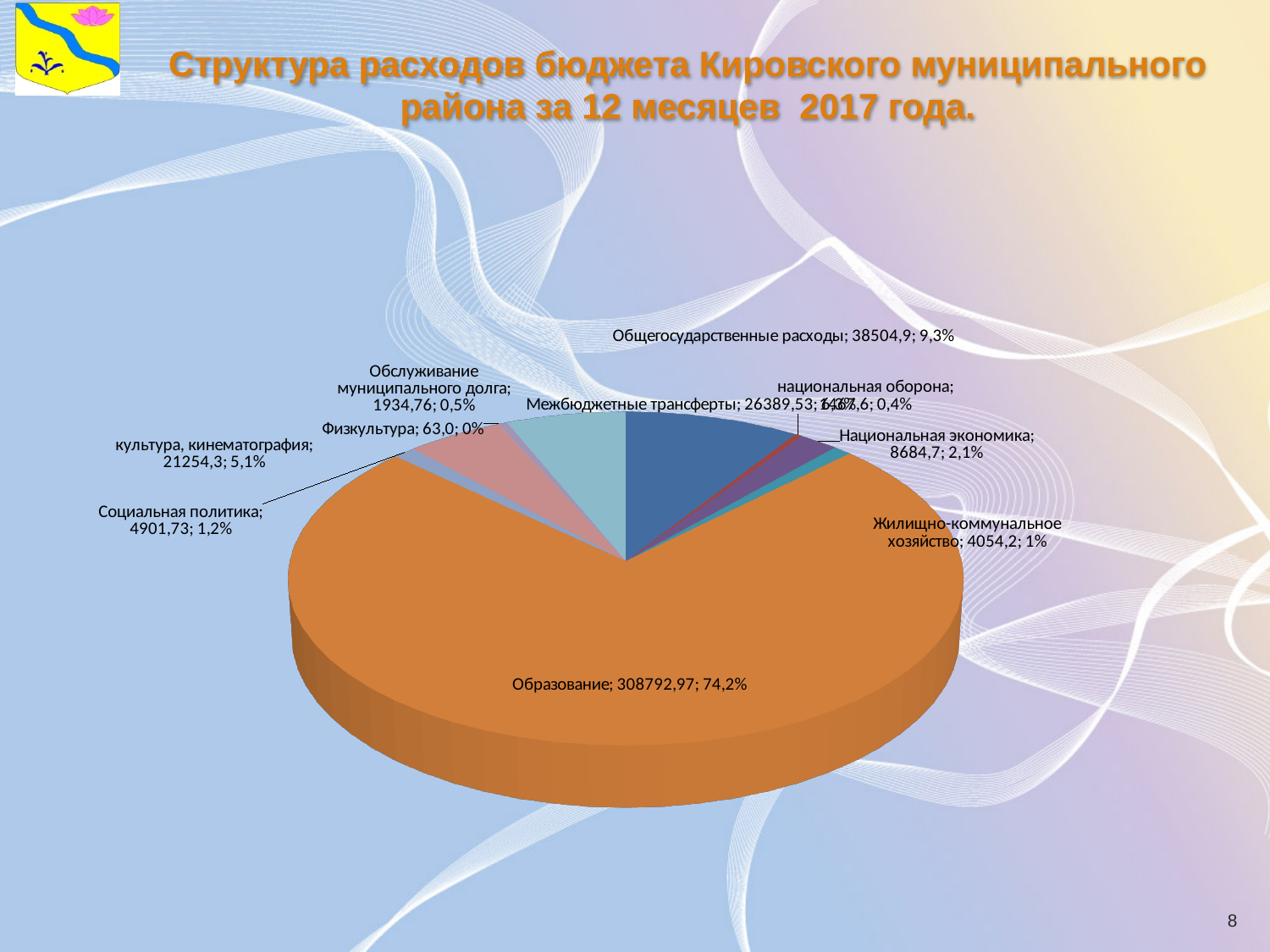
What is the value shown for Общегосударственные расходы? 38504,9 What is the value shown for Образование? 308792,97 Which is larger: the value for Национальная экономика or the value for Жилищно-коммунальное хозяйство? Национальная экономика What is the value shown for Социальная политика? 4901,73 Which category has the smallest share of the budget expenditures? Физкультура What is the difference in percentage share between Общегосударственные расходы and культура, кинематография? 4,2% What share of the pie does Национальная экономика represent? 2,1% How many categories are shown in the pie chart? 10 What share of the pie does Образование represent? 74,2% Which category has the largest share of the budget expenditures? Образование What share of the pie does культура, кинематография represent? 5,1% What kind of chart is shown on the slide? pie chart